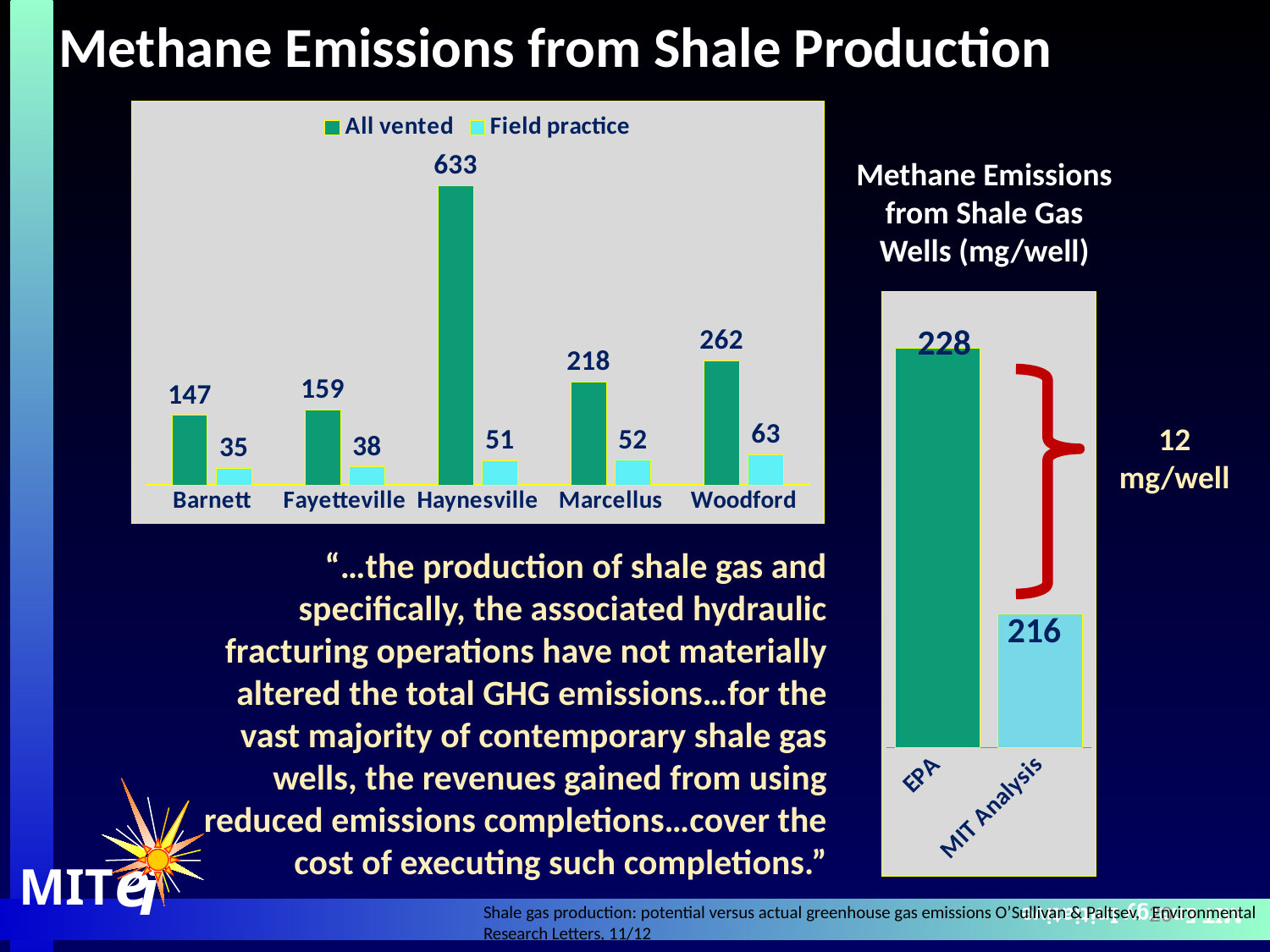
In the left chart, which is larger: the All vented value for Marcellus or the All vented value for Fayetteville? Marcellus In the left chart, what is the difference between the All vented and Field practice values for Woodford? 199 In the left chart, which category has the lowest Field practice value? Barnett In the chart titled 'Methane Emissions from Shale Gas Wells (mg/well)', what is the difference between the EPA and MIT Analysis values? 12 In the left chart, what is the Field practice value for Barnett? 35 In the chart titled 'Methane Emissions from Shale Gas Wells (mg/well)', what is the value for EPA? 228 In the left chart, what is the All vented value for Haynesville? 633 How many series does the legend of the left chart list? 2 How many categories are shown on the x axis of the left chart? 5 What are the two series named in the legend of the left chart? All vented and Field practice In the left chart, which category has the highest All vented value? Haynesville What kind of chart is the left chart? bar chart